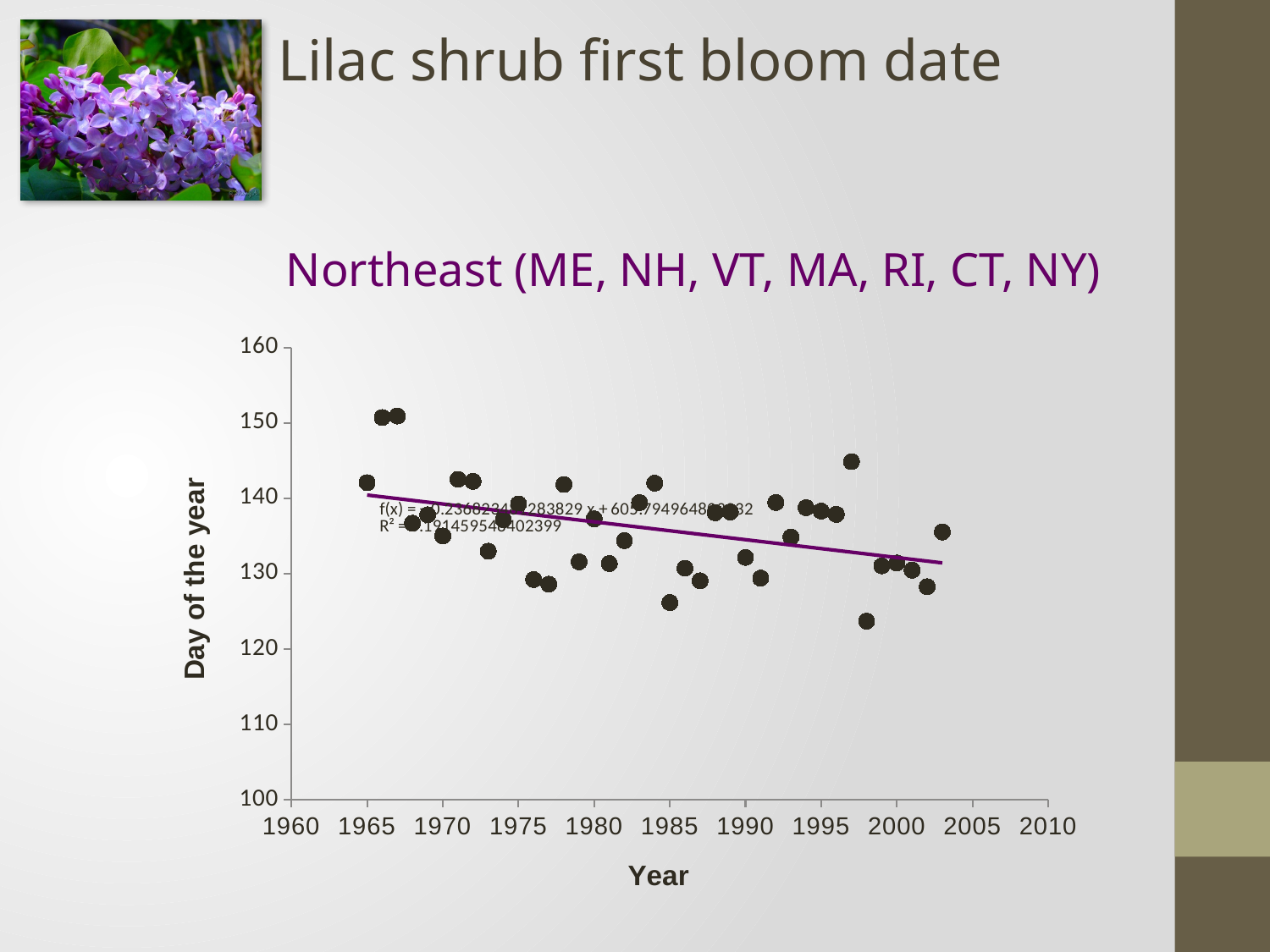
What is the lowest value shown on the vertical axis? 100 Is the lowest point on the chart before or after 1995? after What is the title of the chart? Northeast (ME, NH, VT, MA, RI, CT, NY) Is the value for the point near 1998 greater or less than 130? less Is the value for the point near 1985 greater or less than 130? less What is the label of the vertical axis? Day of the year Do the values generally rise or fall as the year increases along the x axis? fall What kind of chart is shown on the slide? scatter chart Is the value for the point near 2003 greater or less than 130? greater Which has the larger value, the point near 1965 or the point near 2003? the point near 1965